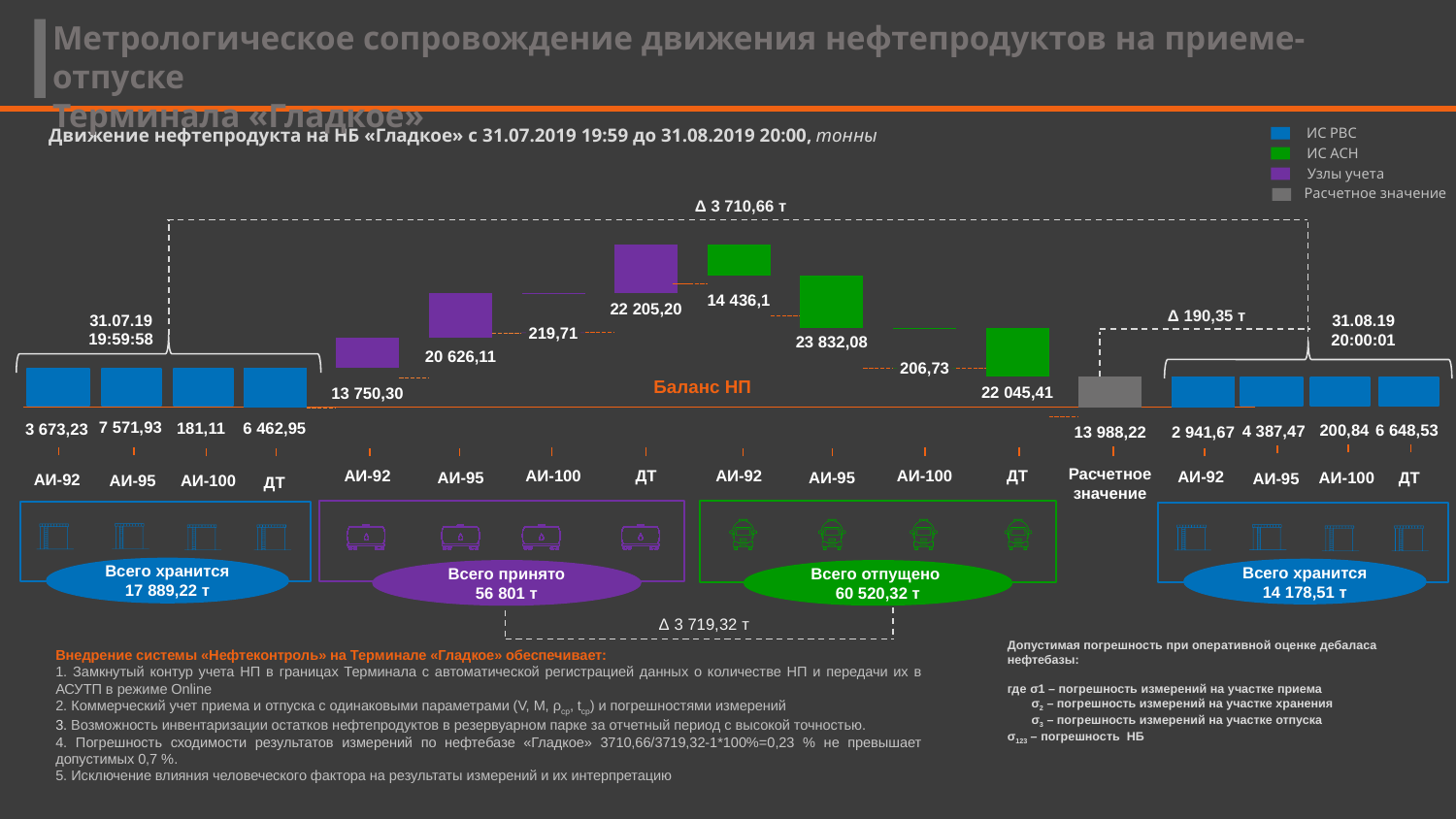
What colour represents 'Узлы учета' in the legend? Purple What is the value for АИ-92 in the green 'Всего отпущено' group? 14 436,1 What is the total 'Всего хранится' at 31.08.19 20:00:01? 14 178,51 т Which product has the highest value in the green 'Всего отпущено' group? АИ-95 What is the difference between 'Всего отпущено' (60 520,32 т) and 'Всего принято' (56 801 т)? 3 719,32 т How many series does the legend list? 4 What unit is stated in the chart title? тонны What is the value for АИ-95 in the 31.07.19 19:59:58 group? 7 571,93 What is the 'Расчетное значение' shown on the chart? 13 988,22 Which is larger: the ДТ value in the 'Всего принято' group or the ДТ value in the 'Всего отпущено' group? Всего принято (22 205,20) Which product has the lowest value in the 31.07.19 19:59:58 group? АИ-100 What is the value for ДТ in the purple 'Всего принято' group? 22 205,20